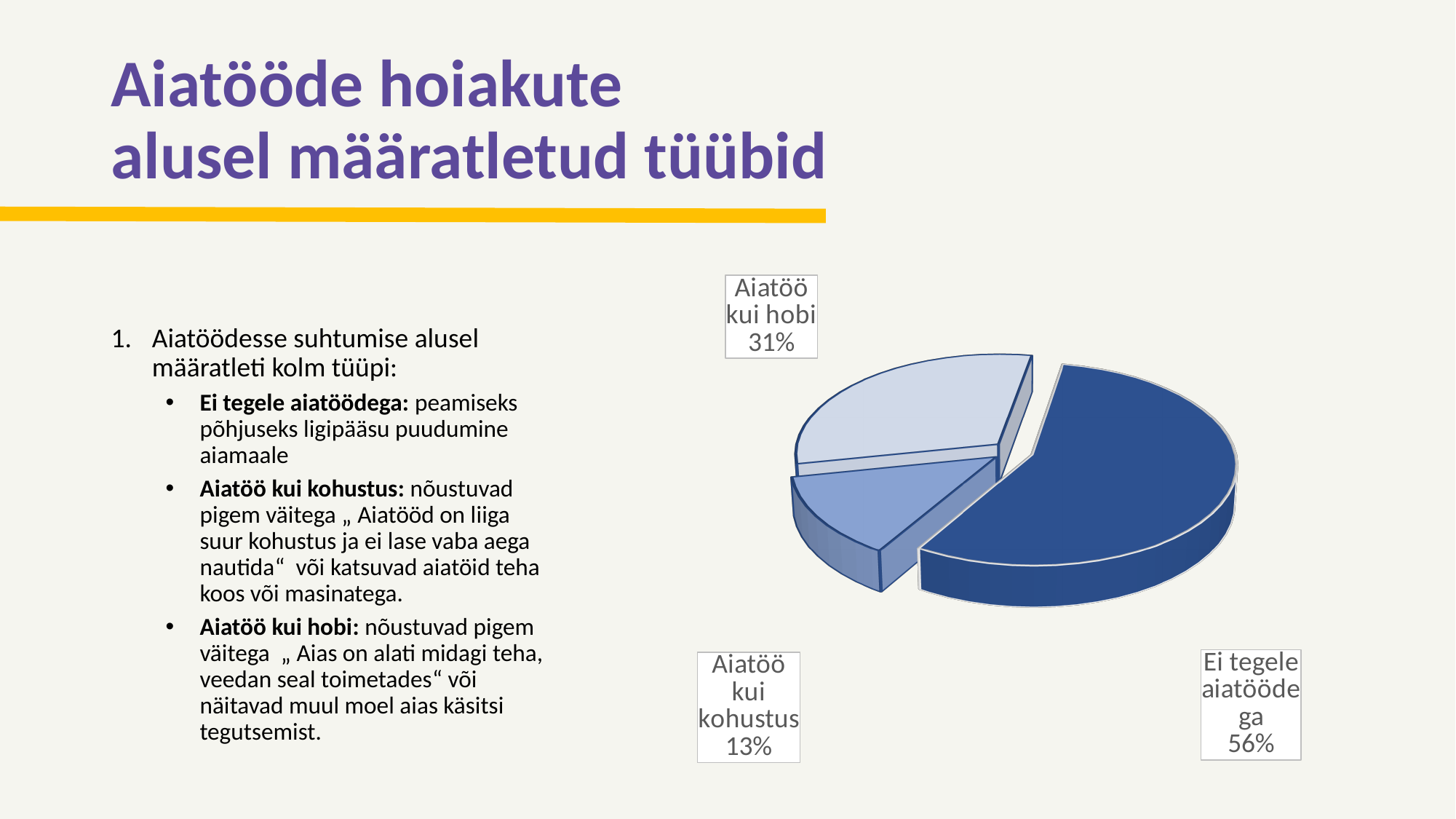
What is the difference in percentage points between "Aiatöö kui hobi" and "Aiatöö kui kohustus"? 18 What kind of chart is shown on the slide? Pie chart What share of the pie does "Ei tegele aiatöödega" represent? 56% Is the share for "Ei tegele aiatöödega" greater or less than 50%? greater What share of the pie does "Aiatöö kui kohustus" represent? 13% What share of the pie does "Aiatöö kui hobi" represent? 31% Which is larger, the share for "Aiatöö kui hobi" or the share for "Aiatöö kui kohustus"? Aiatöö kui hobi What is the difference in percentage points between "Ei tegele aiatöödega" and "Aiatöö kui hobi"? 25 How many categories are shown in the pie chart? 3 Which category has the largest slice of the pie? Ei tegele aiatöödega Which category has the smallest slice of the pie? Aiatöö kui kohustus Which slice of the pie is shown in the darkest blue? Ei tegele aiatöödega